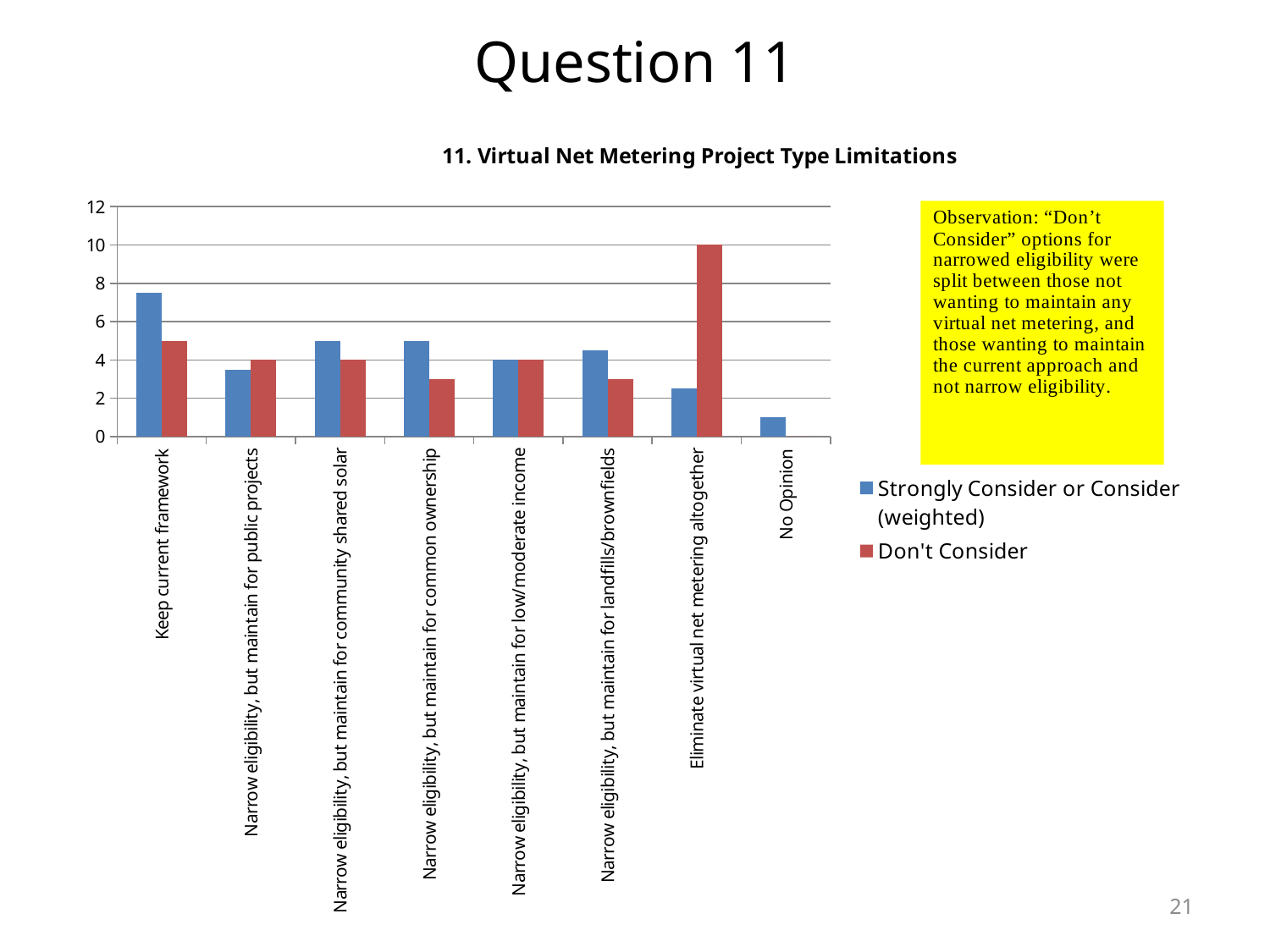
How many series does the legend list? 2 What is the "Strongly Consider or Consider (weighted)" value for "Narrow eligibility, but maintain for low/moderate income"? 4 How many categories are shown on the x axis? 8 What is the "Don't Consider" value for "Eliminate virtual net metering altogether"? 10 Which category has the highest "Strongly Consider or Consider (weighted)" value? Keep current framework What is the "Don't Consider" value for "Narrow eligibility, but maintain for public projects"? 4 Is the "Strongly Consider or Consider (weighted)" value for "Keep current framework" greater or less than 6? greater What type of chart is shown on the slide? Bar chart Which category has the lowest "Strongly Consider or Consider (weighted)" value? No Opinion What is the title of the chart? 11. Virtual Net Metering Project Type Limitations For "Eliminate virtual net metering altogether", which series has the larger value: "Strongly Consider or Consider (weighted)" or "Don't Consider"? Don't Consider Which category has the highest "Don't Consider" value? Eliminate virtual net metering altogether